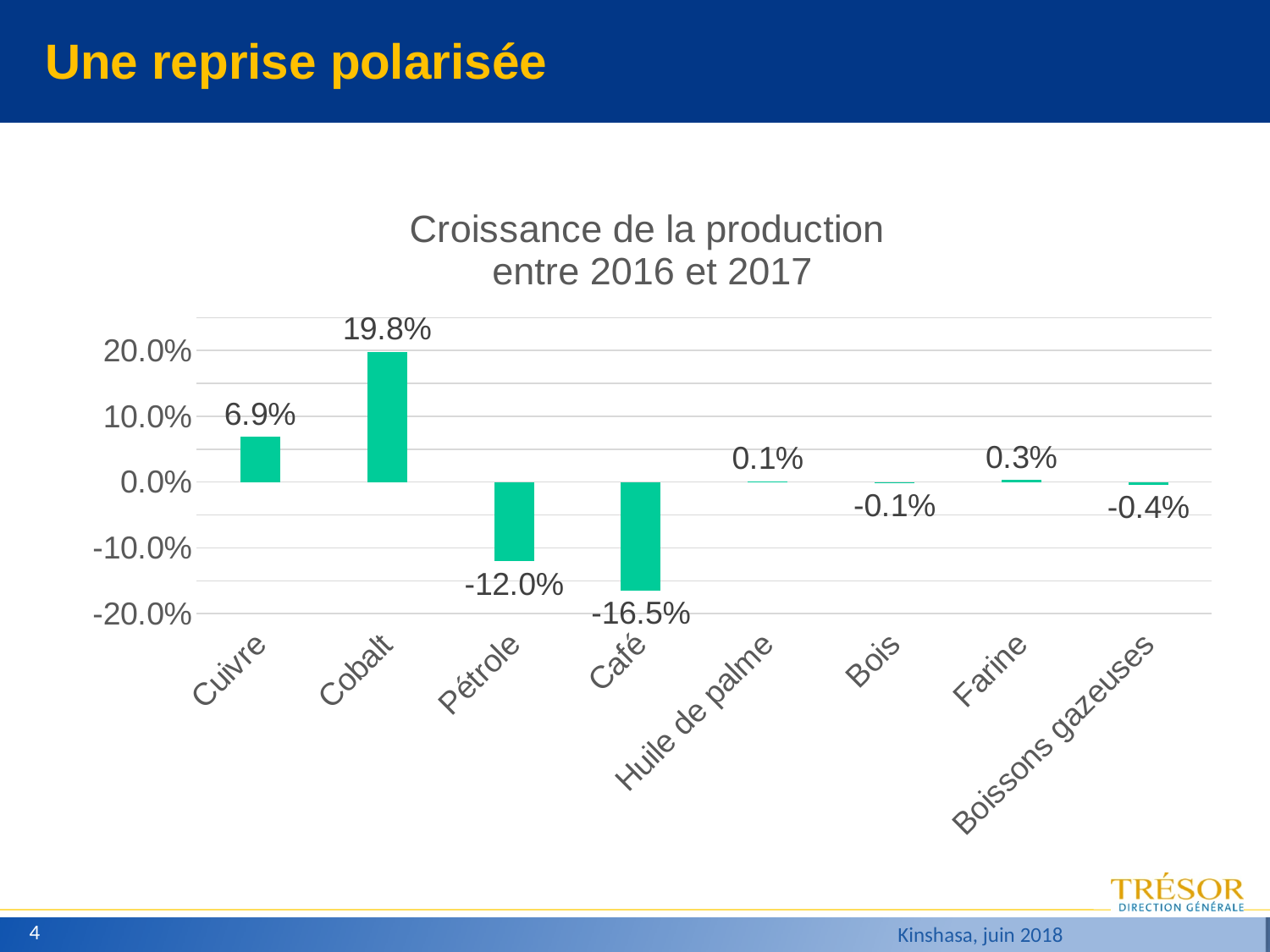
Which is larger, the value for Cuivre or the value for Pétrole? Cuivre What is the difference between the values for Cobalt and Cuivre? 12.9% What is the production growth value for Cobalt? 19.8% How many categories are shown on the x axis? 8 What is the production growth value for Café? -16.5% What kind of chart is shown on the slide? Bar chart What is the production growth value for Farine? 0.3% Which category has the highest production growth? Cobalt Which category has the lowest production growth? Café What is the title of the chart? Croissance de la production entre 2016 et 2017 Is the value for Cobalt greater or less than 10.0%? greater What is the production growth value for Boissons gazeuses? -0.4%